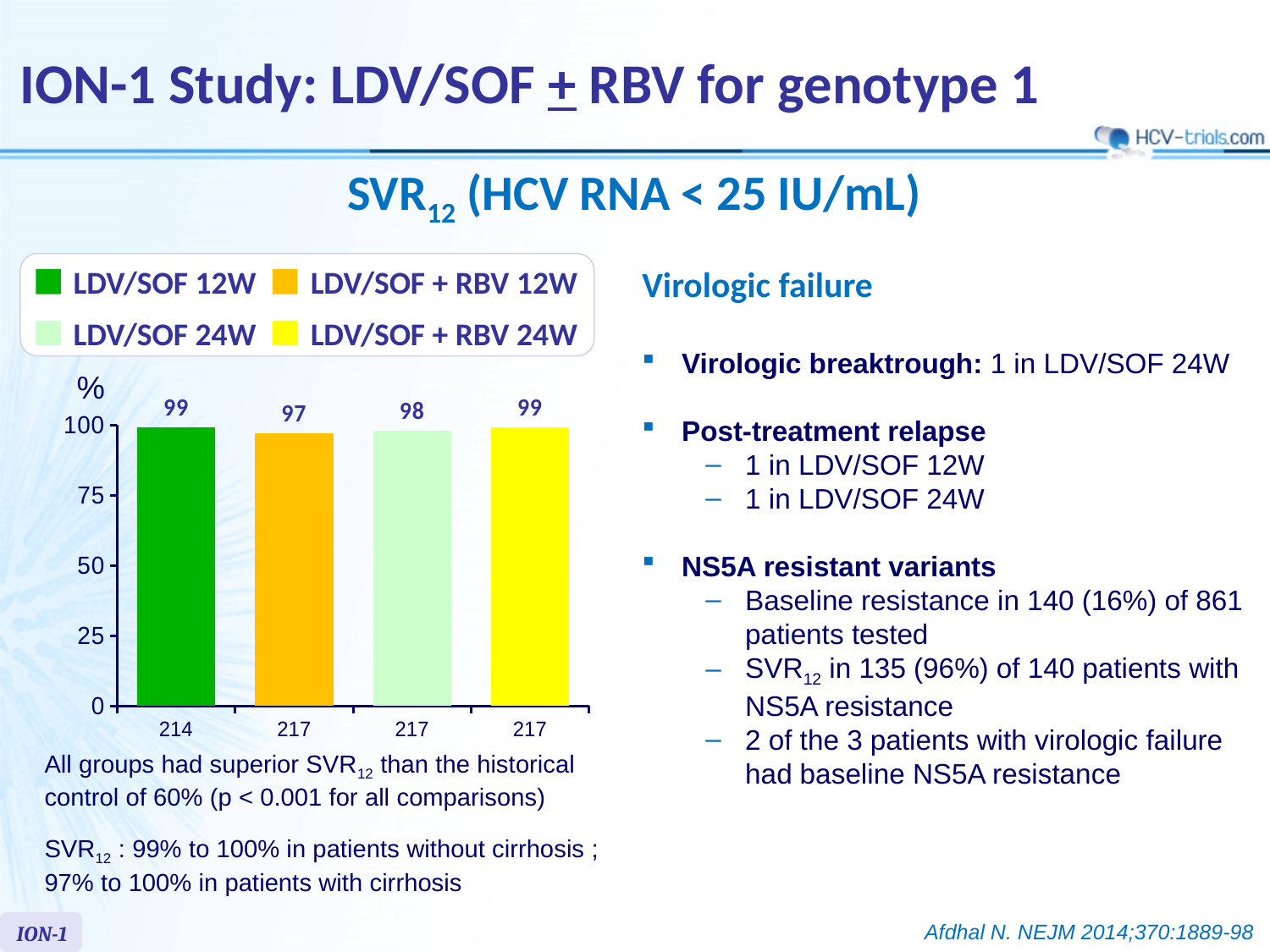
Which has a higher SVR12 value: LDV/SOF 24W or LDV/SOF + RBV 12W? LDV/SOF 24W What is the SVR12 value for the LDV/SOF 12W group? 99 What is the SVR12 value for the LDV/SOF + RBV 24W group? 99 How many bars are shown in the chart? 4 What is the SVR12 value for the LDV/SOF 24W group? 98 What is the difference between the SVR12 values of the LDV/SOF 12W and LDV/SOF + RBV 12W groups? 2 How many treatment groups does the legend list? 4 What type of chart is used to show the SVR12 results? Bar chart What is the SVR12 value for the LDV/SOF + RBV 12W group? 97 How many patients are indicated below the LDV/SOF 12W bar? 214 Which group has the lowest SVR12 value in the chart? LDV/SOF + RBV 12W Is the SVR12 value for the LDV/SOF + RBV 12W group greater or less than 75? greater